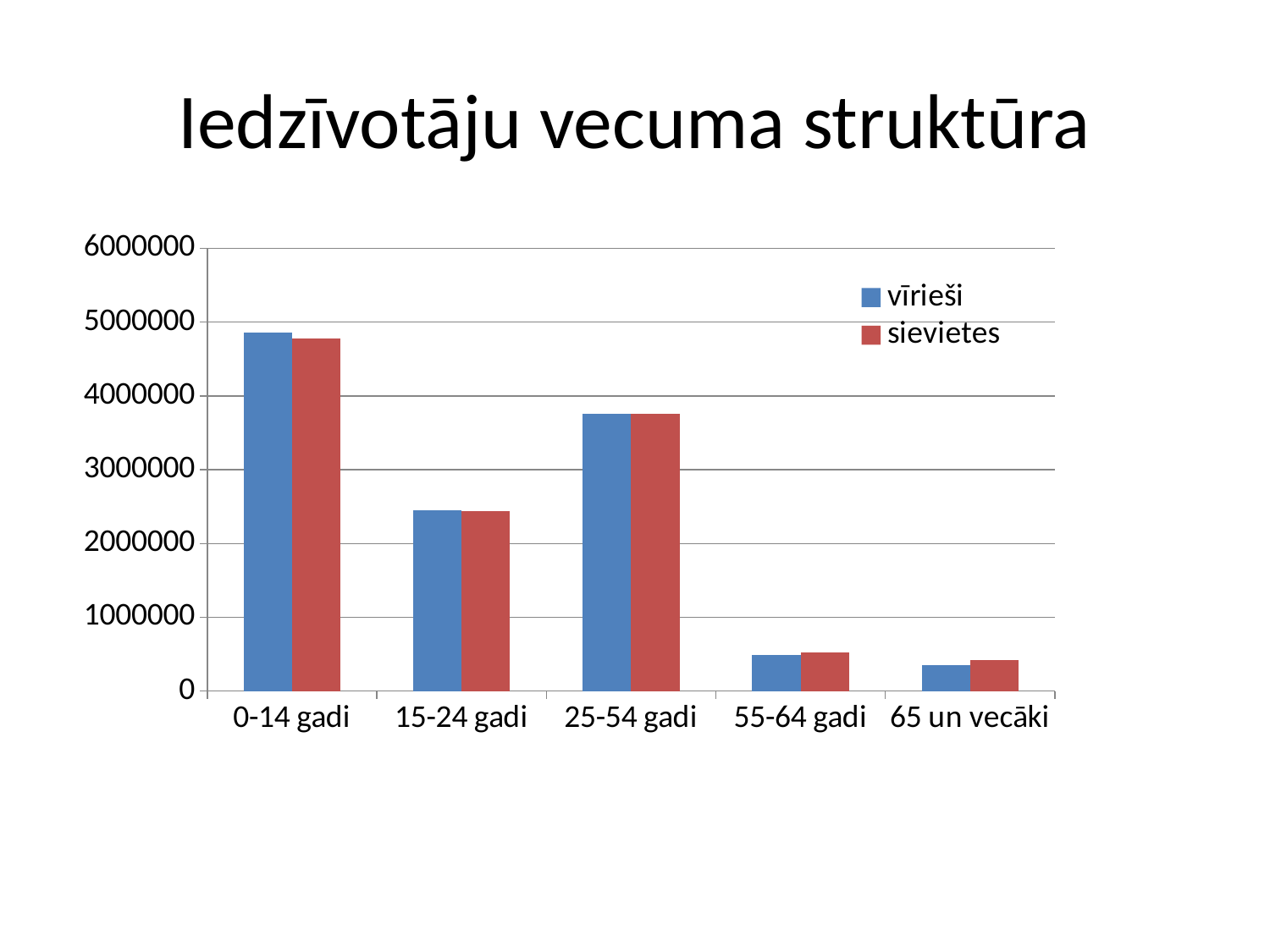
How many age categories are shown on the x axis? 5 Is the value for sievietes in 15-24 gadi greater or less than 2000000? greater Which series is shown in red? sievietes For 65 un vecāki, which is larger: vīrieši or sievietes? sievietes What kind of chart is shown on the slide? bar chart Is the value for vīrieši in 55-64 gadi greater or less than 1000000? less Which age category has the highest value for vīrieši? 0-14 gadi How many series does the legend list? 2 Which age category has the lowest value for vīrieši? 65 un vecāki Is the value for vīrieši in 0-14 gadi greater or less than 4000000? greater What is the title of the chart? Iedzīvotāju vecuma struktūra Which age category has the lowest value for sievietes? 65 un vecāki